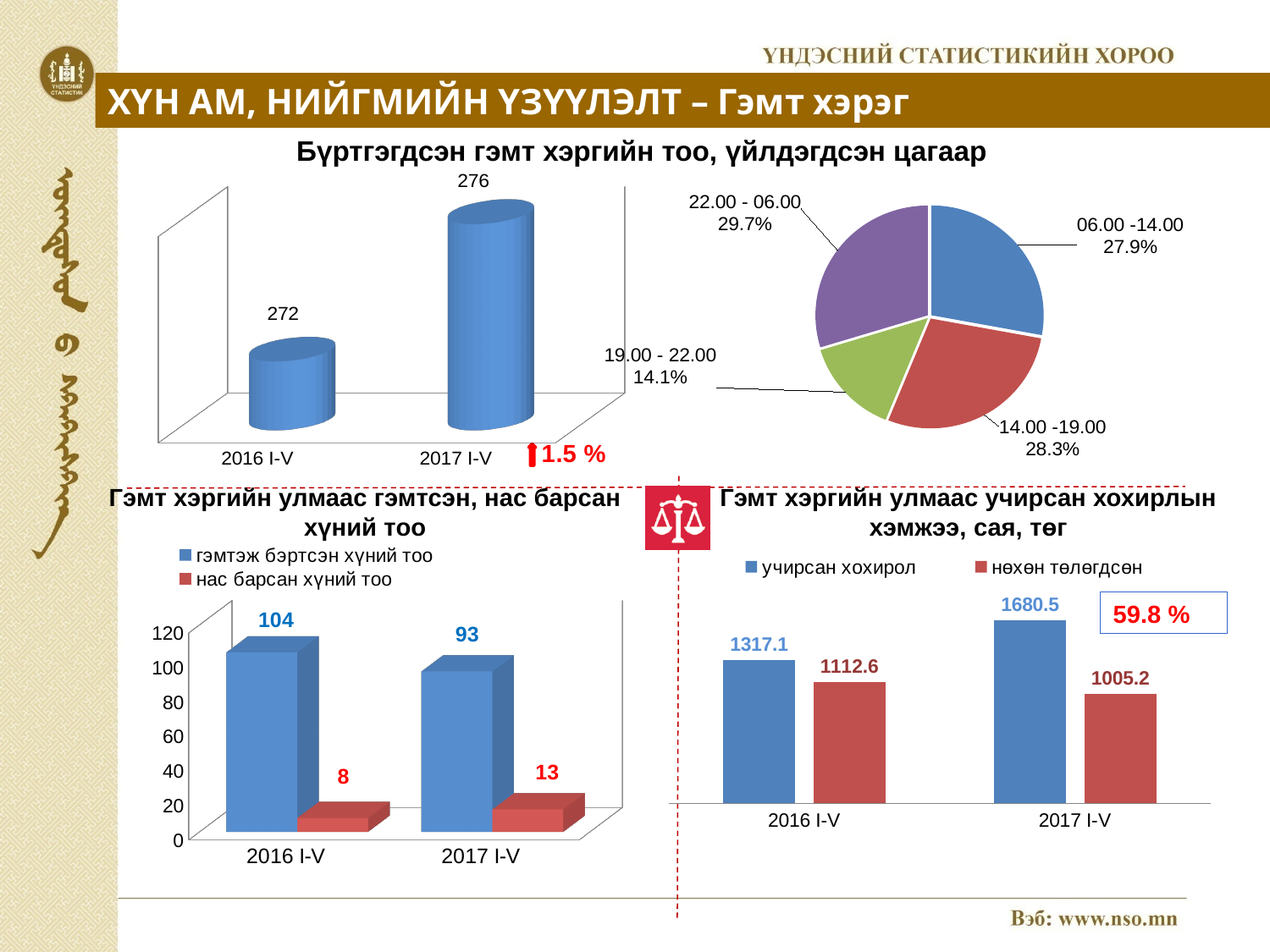
In the bottom-left chart 'Гэмт хэргийн улмаас гэмтсэн, нас барсан хүний тоо', how many series does the legend list? 2 In the bottom-right chart 'Гэмт хэргийн улмаас учирсан хохирлын хэмжээ, сая, төг', what is the value of 'учирсан хохирол' for 2017 I-V? 1680.5 In the top-right pie chart, what share does the '22.00 - 06.00' slice have? 29.7% In the bottom-left chart 'Гэмт хэргийн улмаас гэмтсэн, нас барсан хүний тоо', what is the value of 'гэмтэж бэртсэн хүний тоо' for 2016 I-V? 104 In the top-right pie chart, how many slices are there? 4 In the top-left bar chart under 'Бүртгэгдсэн гэмт хэргийн тоо, үйлдэгдсэн цагаар', what is the value for 2017 I-V? 276 In the top-left bar chart under 'Бүртгэгдсэн гэмт хэргийн тоо, үйлдэгдсэн цагаар', what is the difference between the 2017 I-V and 2016 I-V values? 4 In the bottom-left chart 'Гэмт хэргийн улмаас гэмтсэн, нас барсан хүний тоо', does 'гэмтэж бэртсэн хүний тоо' rise or fall from 2016 I-V to 2017 I-V? fall What type of chart is the bottom-right chart 'Гэмт хэргийн улмаас учирсан хохирлын хэмжээ, сая, төг'? bar chart In the bottom-right chart 'Гэмт хэргийн улмаас учирсан хохирлын хэмжээ, сая, төг', which is larger for 2016 I-V: 'учирсан хохирол' or 'нөхөн төлөгдсөн'? учирсан хохирол In the top-right pie chart, which time period has the smallest share? 19.00 - 22.00 In the bottom-left chart 'Гэмт хэргийн улмаас гэмтсэн, нас барсан хүний тоо', what is the value of 'нас барсан хүний тоо' for 2017 I-V? 13